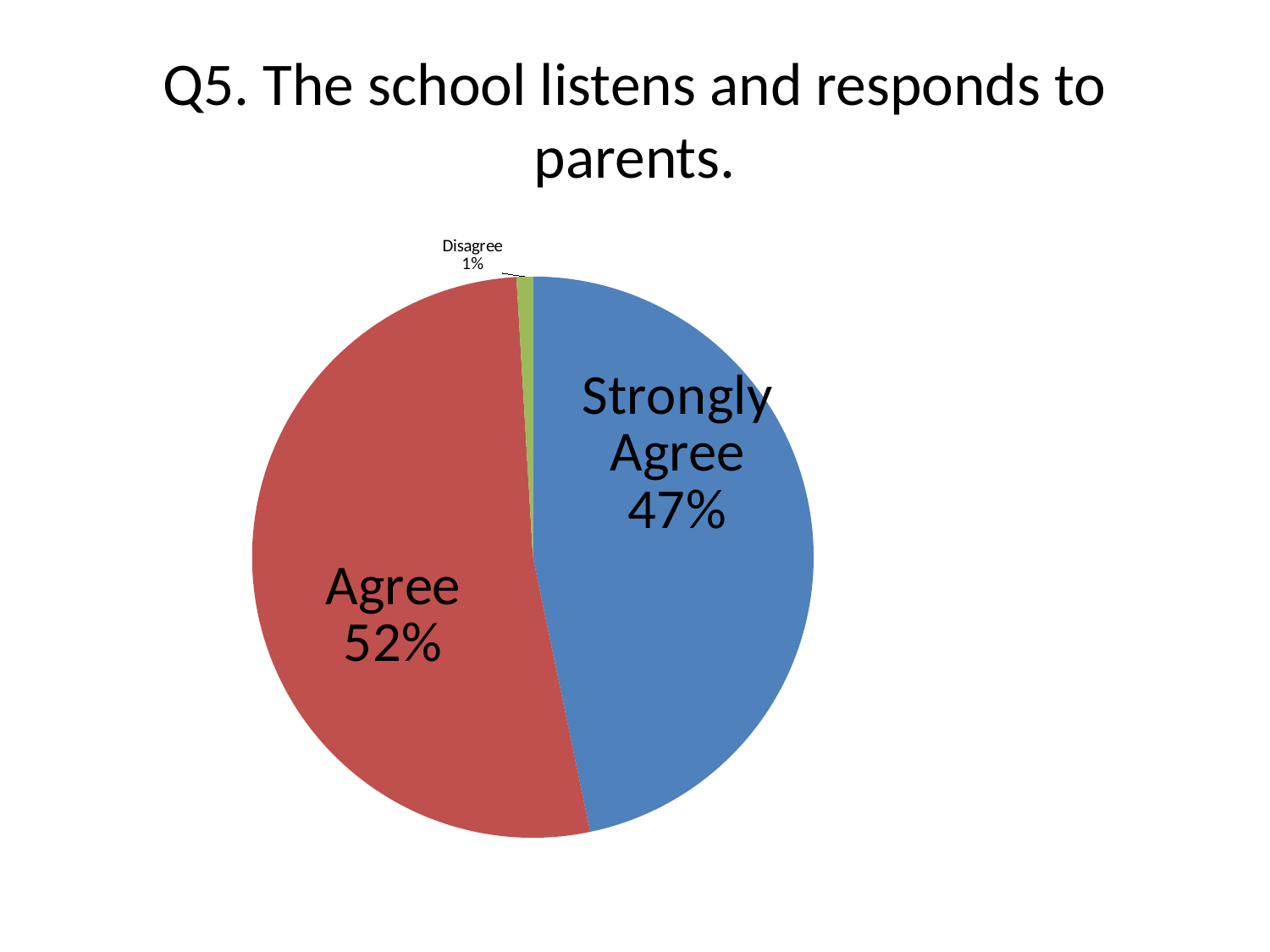
What colour is the Agree slice? red What percentage of respondents chose Disagree? 1% What is the difference in percentage points between Strongly Agree and Disagree? 46 What is the difference in percentage points between Agree and Strongly Agree? 5 What percentage of respondents chose Strongly Agree? 47% What is the title of the chart? Q5. The school listens and responds to parents. What kind of chart is shown on the slide? pie chart Which response has the smallest share of the pie? Disagree What percentage of respondents chose Agree? 52% How many slices does the pie chart have? 3 Which response has the largest share of the pie? Agree Which is larger, the share for Agree or the share for Strongly Agree? Agree